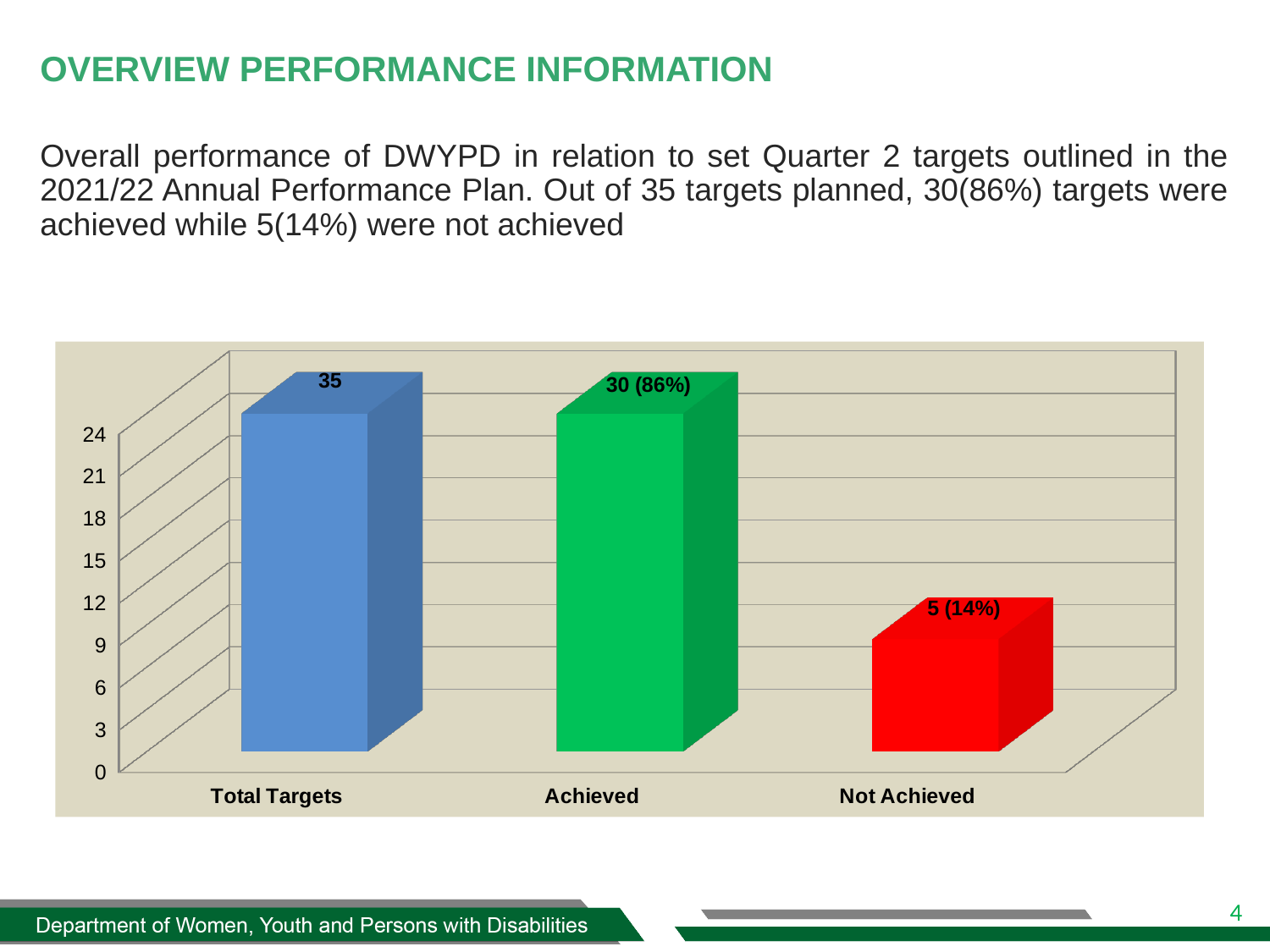
What is the value shown for Total Targets? 35 Which is larger, the value for Achieved or the value for Not Achieved? Achieved Which category has the lowest value? Not Achieved What kind of chart is shown on the slide? bar chart What colour is the Not Achieved bar? red What data label is shown on the Not Achieved bar? 5 (14%) How many categories are shown on the x axis? 3 Which category has the highest value? Total Targets What is the difference between the Total Targets value and the Achieved value? 5 What is the difference between the Achieved value and the Not Achieved value? 25 What data label is shown on the Achieved bar? 30 (86%) Is the value for Not Achieved greater or less than 12? less